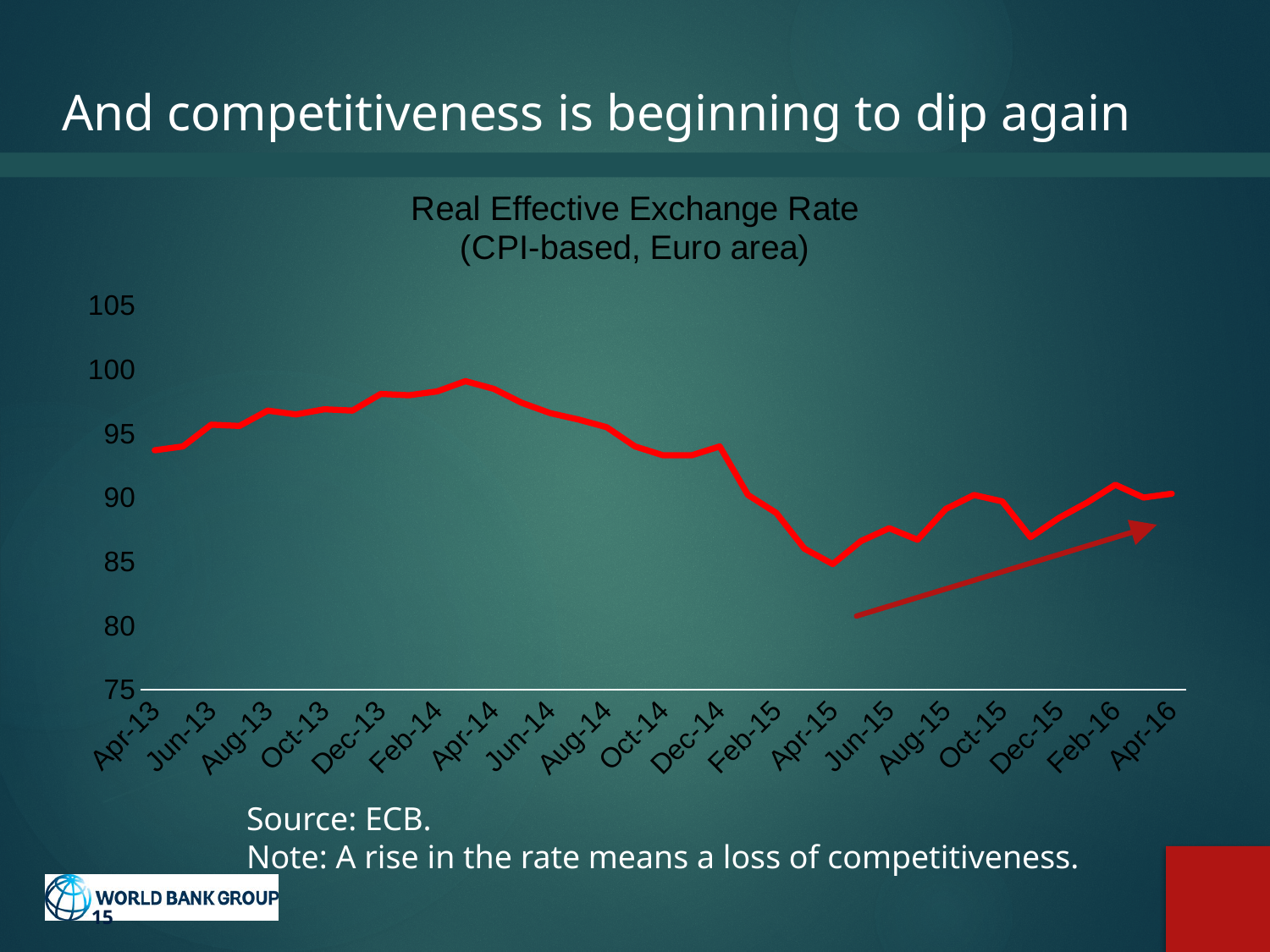
What kind of chart is shown on the slide? line chart Is the value for Apr-15 greater or less than 90? less What is the title of the chart? Real Effective Exchange Rate (CPI-based, Euro area) Around which month does the Real Effective Exchange Rate reach its lowest point? Apr-15 Which is larger, the value for Apr-14 or the value for Apr-15? Apr-14 How many month labels are shown on the x axis? 19 Is the value for Apr-13 greater or less than 95? less Is the value for Dec-15 greater or less than 90? less What colour is the plotted line in the chart? red Does the Real Effective Exchange Rate rise or fall between Apr-14 and Apr-15? fall